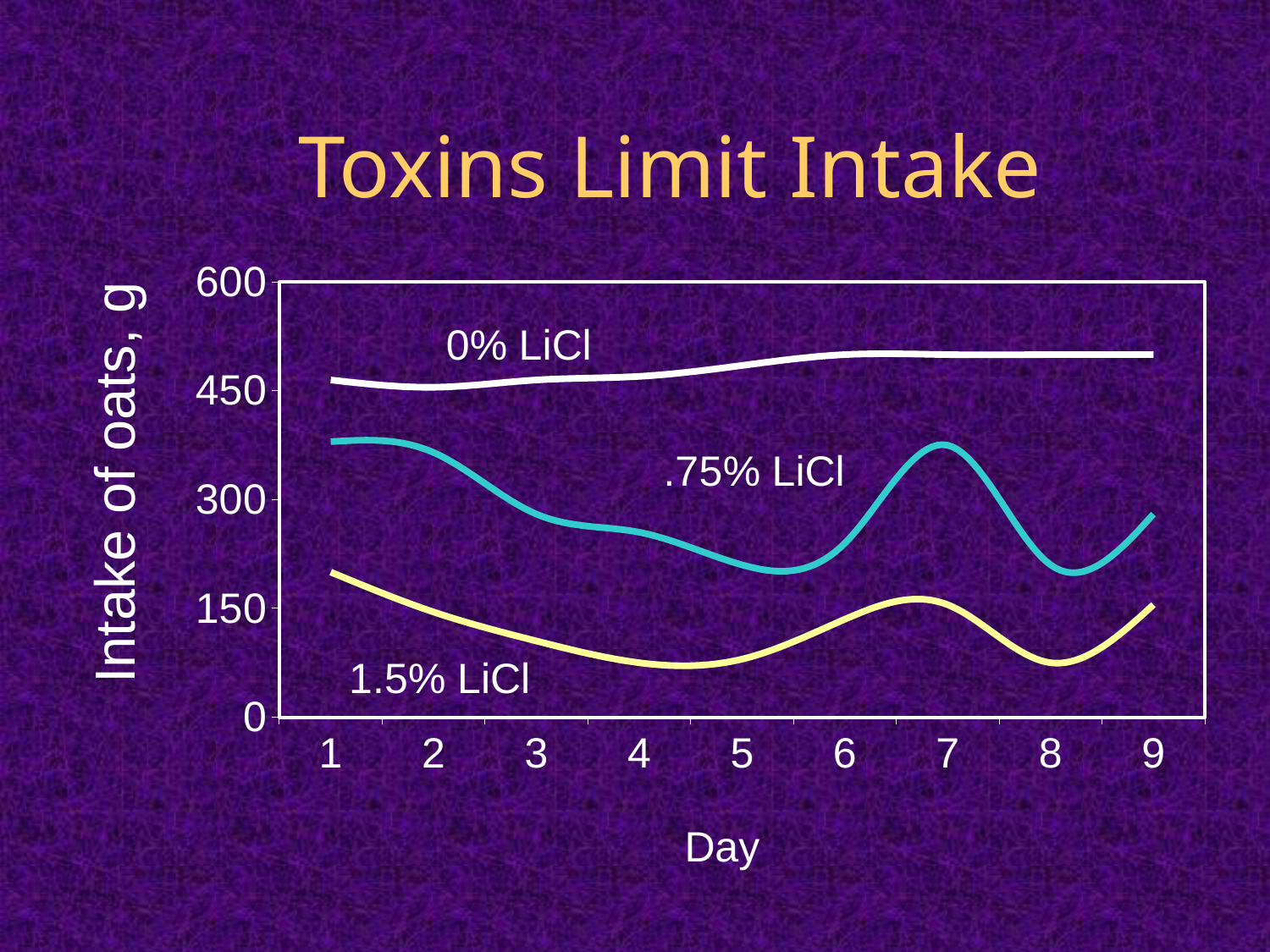
Does the 1.5% LiCl line rise or fall from day 1 to day 4? fall Which series has the lowest intake of oats across the days? 1.5% LiCl On day 7, which series has the higher intake: .75% LiCl or 1.5% LiCl? .75% LiCl Is the value for .75% LiCl on day 7 greater or less than 300? greater How many series (LiCl levels) are plotted on the chart? 3 What kind of chart is shown on the slide? line chart Is the value for 1.5% LiCl on day 5 greater or less than 150? less Which series has the highest intake of oats across the days? 0% LiCl What is the label of the y axis? Intake of oats, g What is the title of the slide? Toxins Limit Intake Is the value for 0% LiCl on day 1 greater or less than 300? greater How many days are shown along the x axis? 9